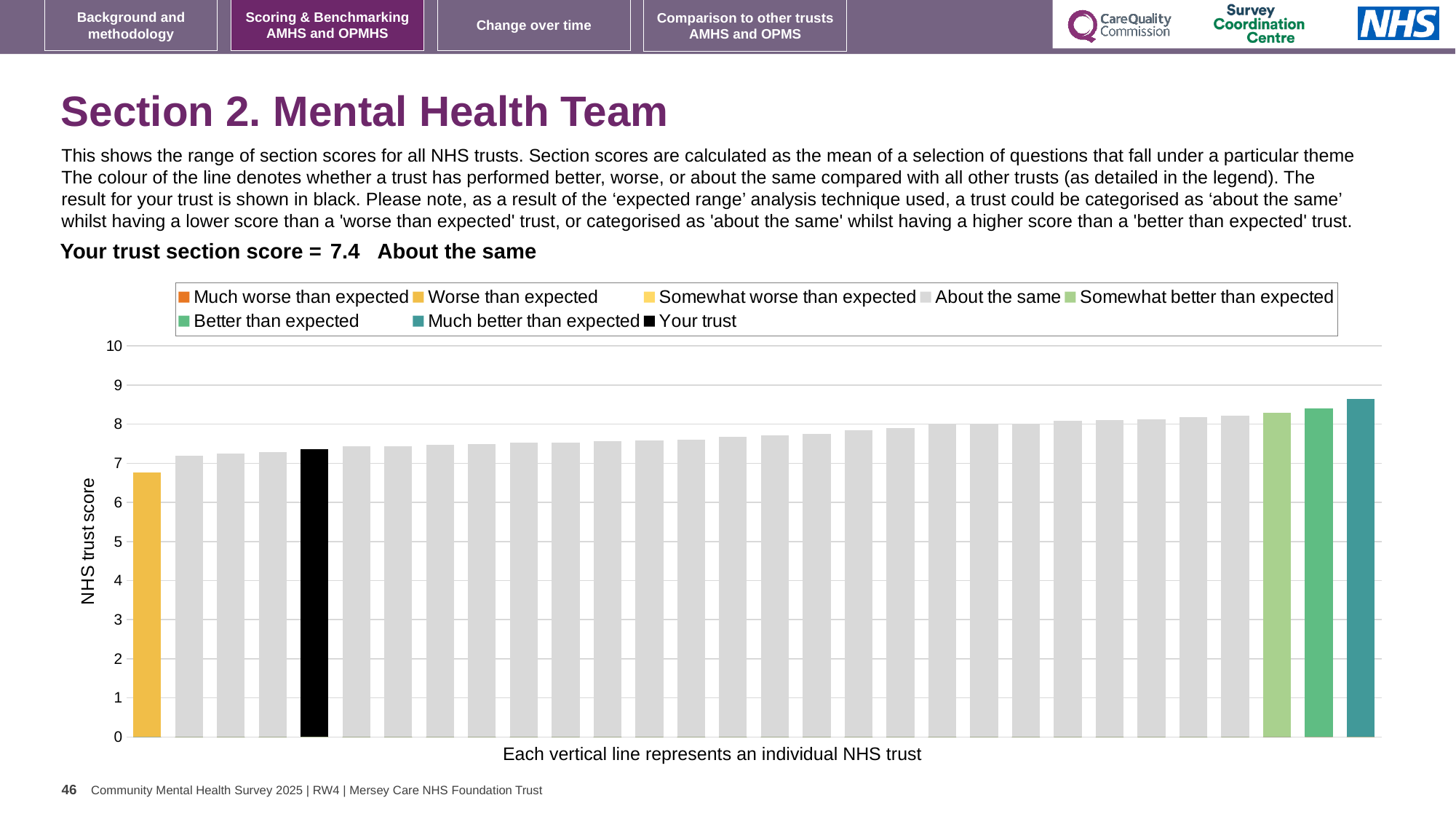
Is the value of the leftmost (lowest) bar greater or less than 7? less Is the value of the rightmost (highest) bar greater or less than 8? greater Which legend category does the lowest-scoring trust (leftmost bar) belong to? Worse than expected What is the label on the vertical axis of the chart? NHS trust score How many entries does the chart legend list? 8 Is the value of the black 'Your trust' bar greater or less than 8? less Do the bar values rise or fall from left to right along the x axis? Rise What is the section score for your trust shown on the slide? 7.4 Which legend category does the highest-scoring trust (rightmost bar) belong to? Much better than expected What kind of chart is shown on the slide? Bar chart